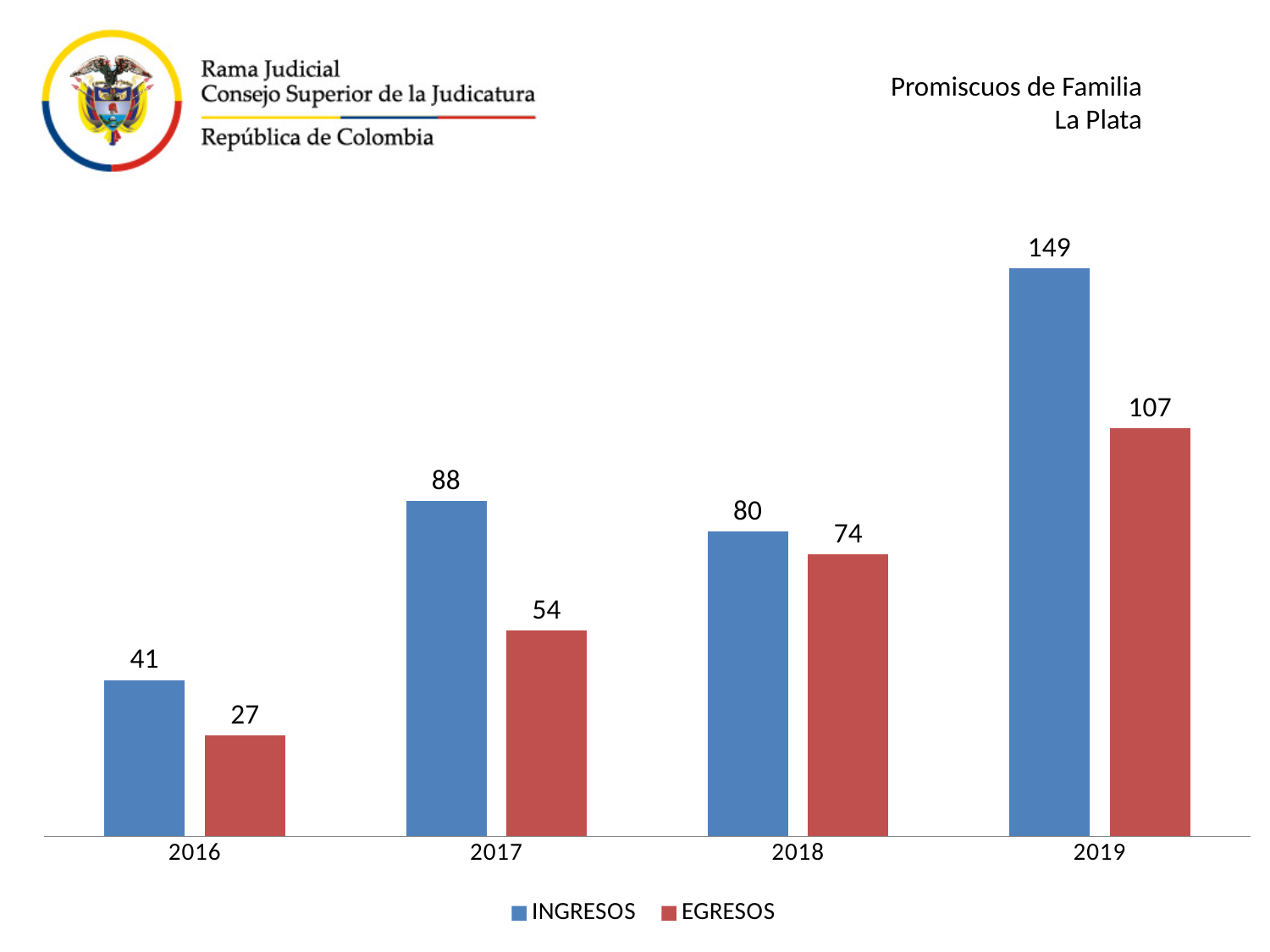
How many years are shown on the x axis? 4 What kind of chart is shown on the slide? Bar chart Do the EGRESOS values rise or fall from 2016 to 2019? Rise What is the difference between INGRESOS and EGRESOS in 2019? 42 Which year has the highest INGRESOS value? 2019 Which year has the lowest EGRESOS value? 2016 What is the difference between INGRESOS in 2018 and INGRESOS in 2016? 39 What is the INGRESOS value for 2017? 88 How many series does the legend list? 2 Which is larger in 2018, INGRESOS or EGRESOS? INGRESOS What is the EGRESOS value for 2019? 107 What is the EGRESOS value for 2016? 27